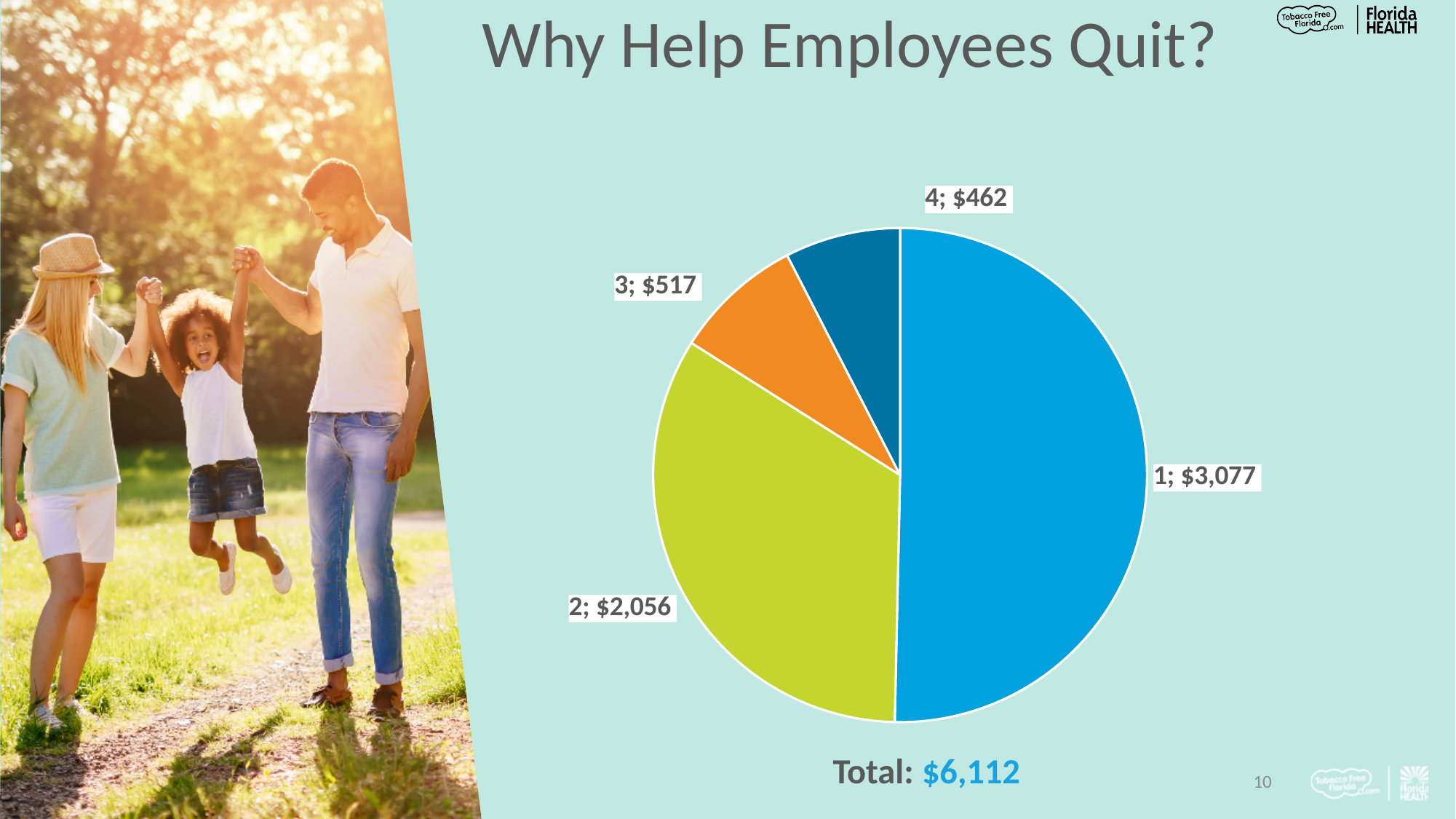
Which slice of the pie chart has the highest value? 1 Which slice of the pie chart has the lowest value? 4 What is the title of the slide containing the pie chart? Why Help Employees Quit? What is the value for slice 1 in the pie chart? $3,077 What is the value for slice 3 in the pie chart? $517 What is the difference between the values for slice 1 and slice 2? $1,021 What is the value for slice 4 in the pie chart? $462 What is the difference between the values for slice 3 and slice 4? $55 What is the total shown below the pie chart? $6,112 What is the value for slice 2 in the pie chart? $2,056 What kind of chart is shown on the slide? pie chart How many slices does the pie chart have? 4